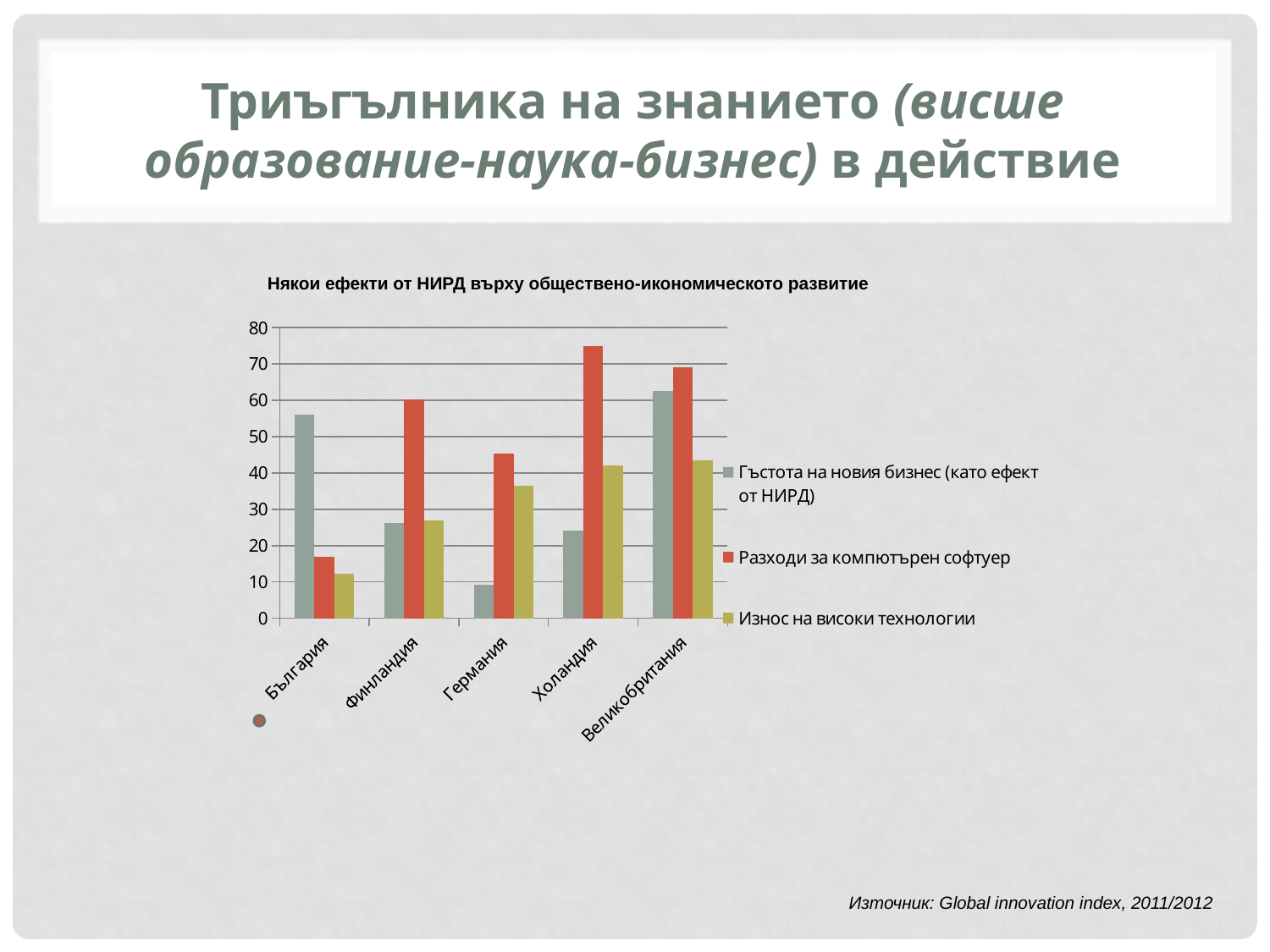
Is the value for Гъстота на новия бизнес (като ефект от НИРД) for България greater or less than 50? greater Which country has the larger value for Разходи за компютърен софтуер, Финландия or Великобритания? Великобритания How many countries are shown on the x axis of the chart? 5 For България, which is larger: Гъстота на новия бизнес (като ефект от НИРД) or Разходи за компютърен софтуер? Гъстота на новия бизнес (като ефект от НИРД) What kind of chart is shown on the slide? bar chart Is the value for Разходи за компютърен софтуер for Холандия greater or less than 70? greater Which country has the lowest value for Износ на високи технологии? България What is the title of the chart? Някои ефекти от НИРД върху обществено-икономическото развитие Which country has the highest value for Разходи за компютърен софтуер? Холандия Is the value for Разходи за компютърен софтуер for Германия greater or less than 40? greater Which country has the lowest value for Гъстота на новия бизнес (като ефект от НИРД)? Германия How many series does the chart legend list? 3